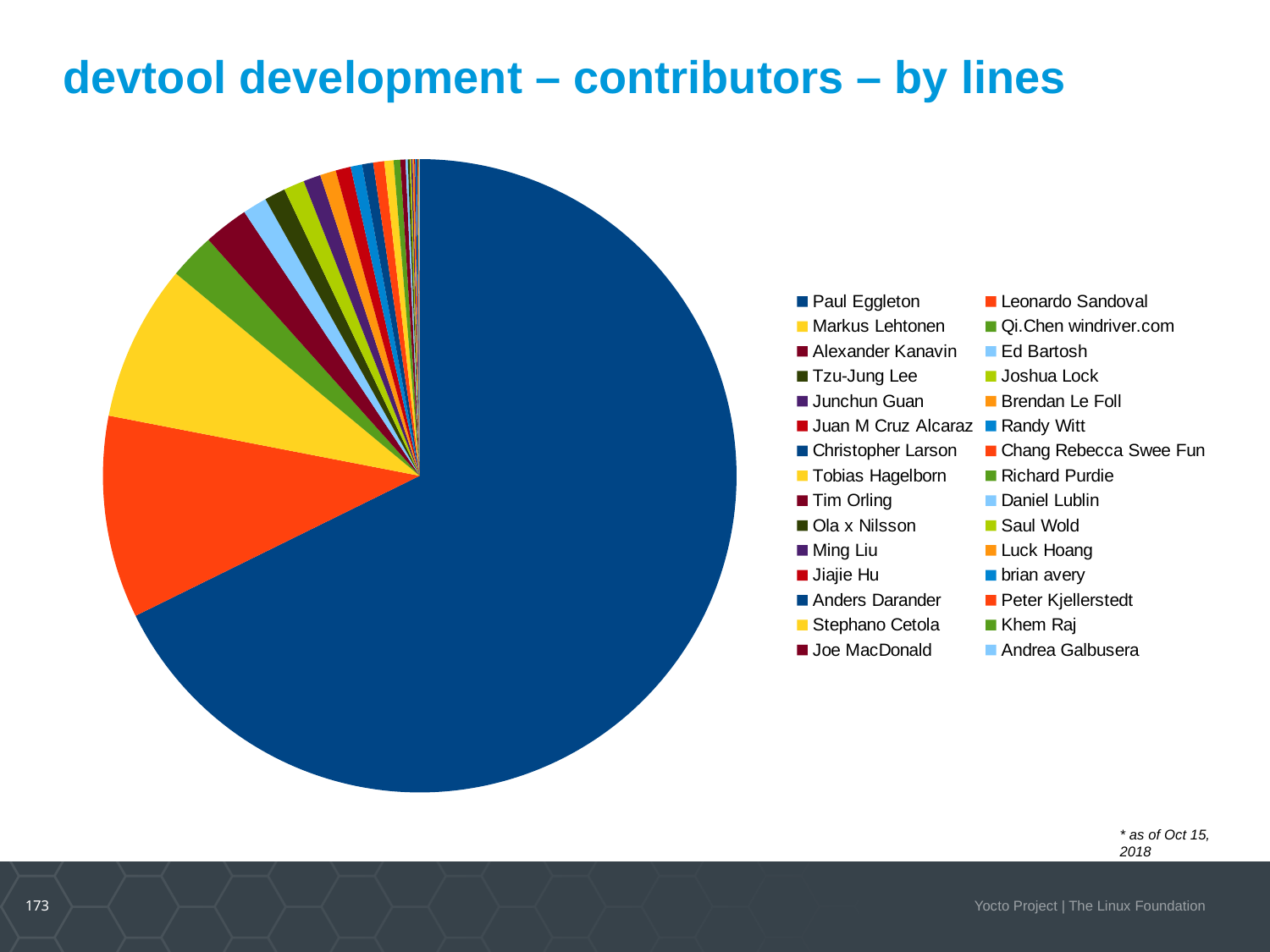
Which contributor has the largest slice of the pie? Paul Eggleton How many contributors are listed in the legend? 30 What kind of chart is shown on the slide? pie chart Which slice is larger, Markus Lehtonen's or Alexander Kanavin's? Markus Lehtonen What is the title of the slide containing the chart? devtool development – contributors – by lines Which slice is larger, Paul Eggleton's or Leonardo Sandoval's? Paul Eggleton Which contributor has the second-largest slice of the pie? Leonardo Sandoval Is Paul Eggleton's share of the pie greater or less than 50%? greater As of what date is the chart data, according to the footnote? Oct 15, 2018